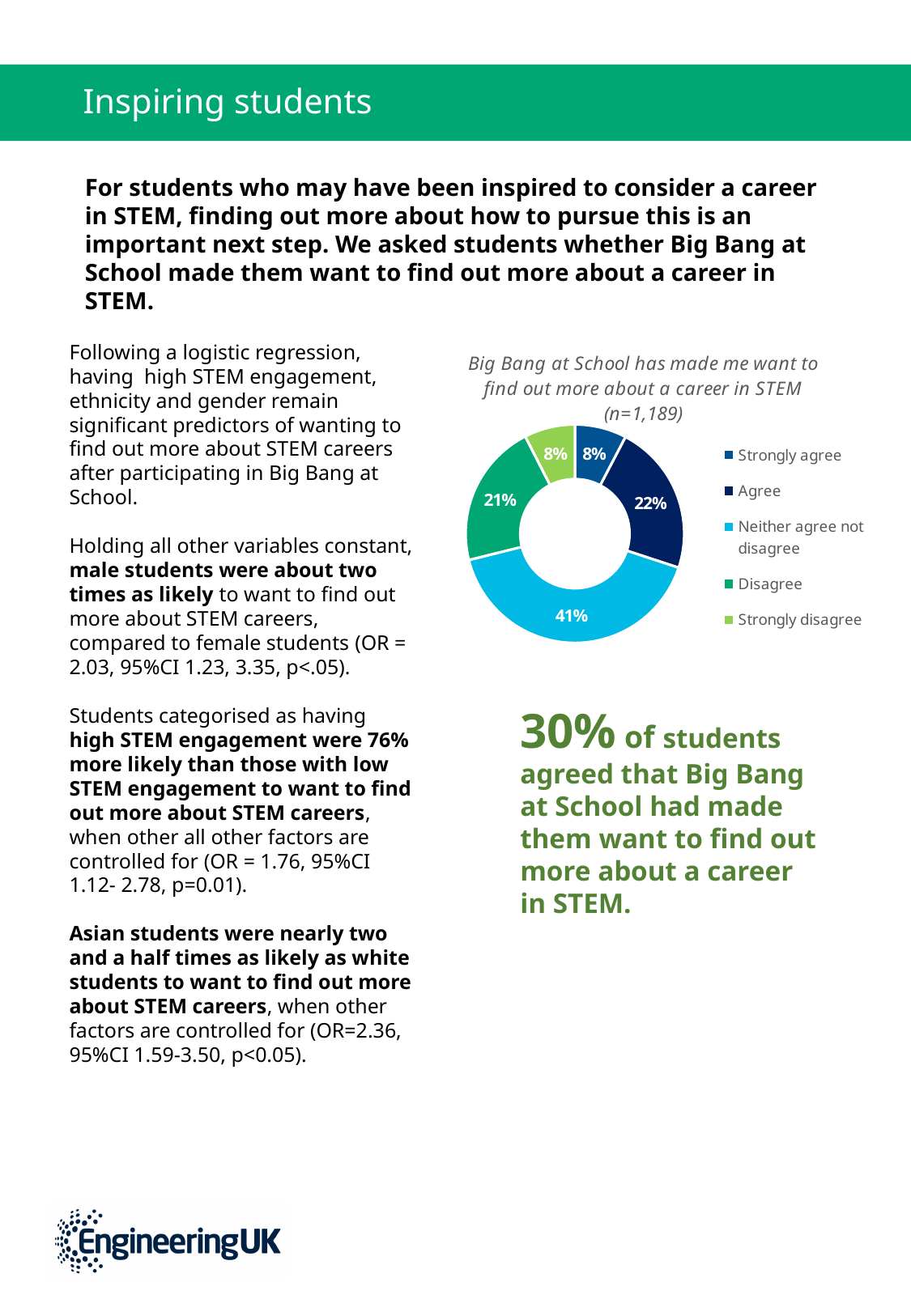
What type of chart is shown on the slide? Pie chart (doughnut) Which legend entry is shown in light green in the chart? Strongly disagree What percentage of students selected 'Strongly agree' in the chart? 8% Which is larger in the chart: the share for 'Agree' or the share for 'Disagree'? Agree Which response category has the largest share in the chart? Neither agree not disagree What is the combined share of 'Strongly agree' and 'Agree' in the chart? 30% What is the difference in percentage points between 'Neither agree not disagree' and 'Agree'? 19 What percentage of students selected 'Disagree' in the chart? 21% What sample size (n) is given in the chart title? n=1,189 How many response categories are shown in the chart? 5 What percentage of students selected 'Agree' in the chart? 22% What percentage of students selected 'Neither agree not disagree' in the chart? 41%